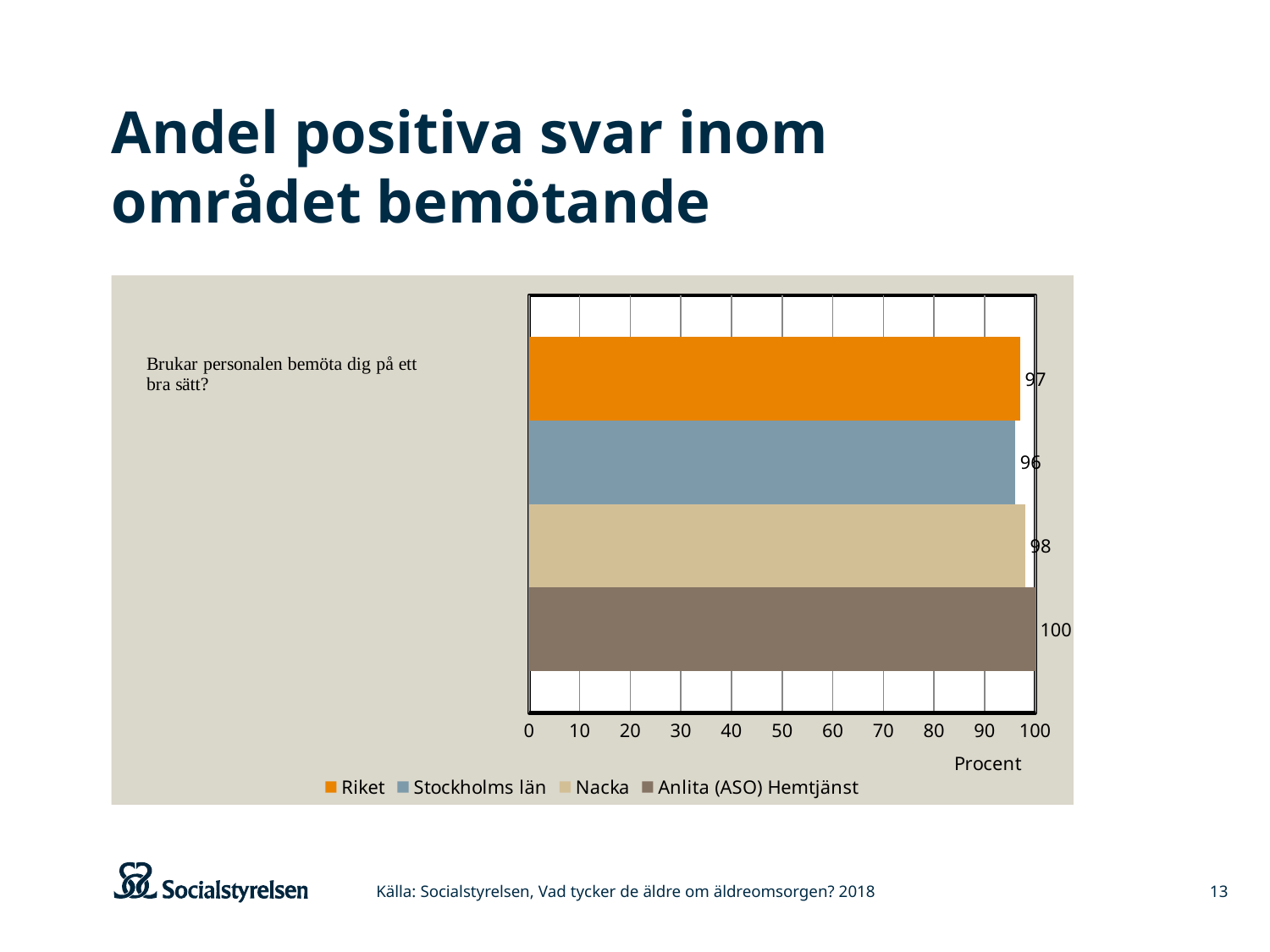
Which series has the highest value? Anlita (ASO) Hemtjänst What is the value for Stockholms län? 96 Which series has the lowest value? Stockholms län What is the difference between the values for Nacka and Riket? 1 What is the difference between the values for Anlita (ASO) Hemtjänst and Stockholms län? 4 What kind of chart is shown on the slide? Bar chart What is the value for Riket? 97 What is the label of the x axis? Procent What is the title of the slide? Andel positiva svar inom området bemötande How many series does the legend list? 4 What is the value for Anlita (ASO) Hemtjänst? 100 What is the value for Nacka? 98